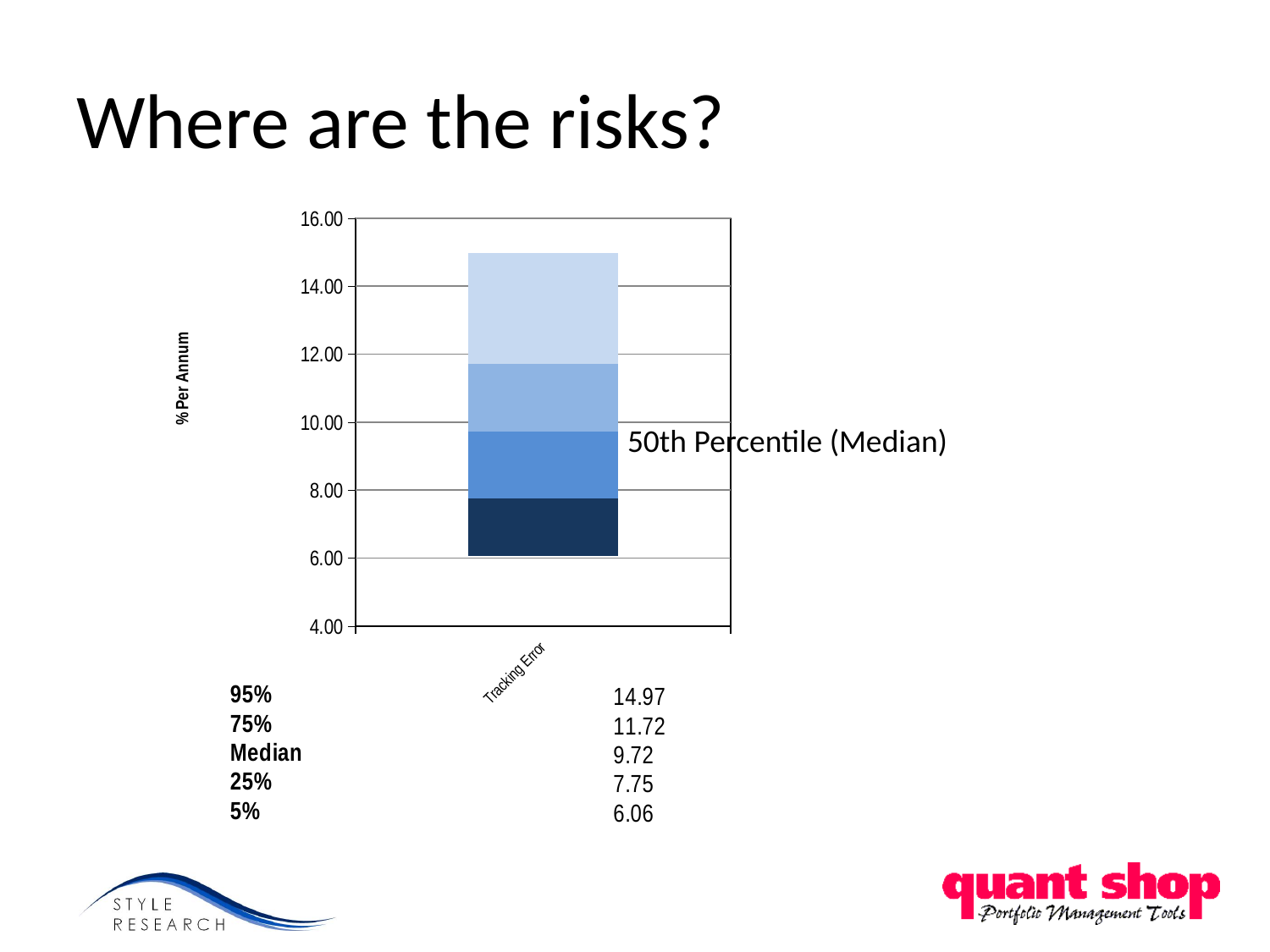
How many categories are shown on the x axis of the chart? 1 Is the top of the Tracking Error bar greater or less than 14.00? greater What is the 75% value of Tracking Error shown on the slide? 11.72 What is the 25% value of Tracking Error shown on the slide? 7.75 What is the 5% value of Tracking Error shown on the slide? 6.06 What is the difference between the 95% and 5% values of Tracking Error? 8.91 Which is larger, the 75% value or the Median value of Tracking Error? 75% What kind of chart is shown on the slide? bar chart What is the difference between the 75% and 25% values of Tracking Error? 3.97 What is the label of the vertical axis of the chart? % Per Annum What is the 95th percentile value of Tracking Error shown on the slide? 14.97 What is the Median value of Tracking Error shown on the slide? 9.72